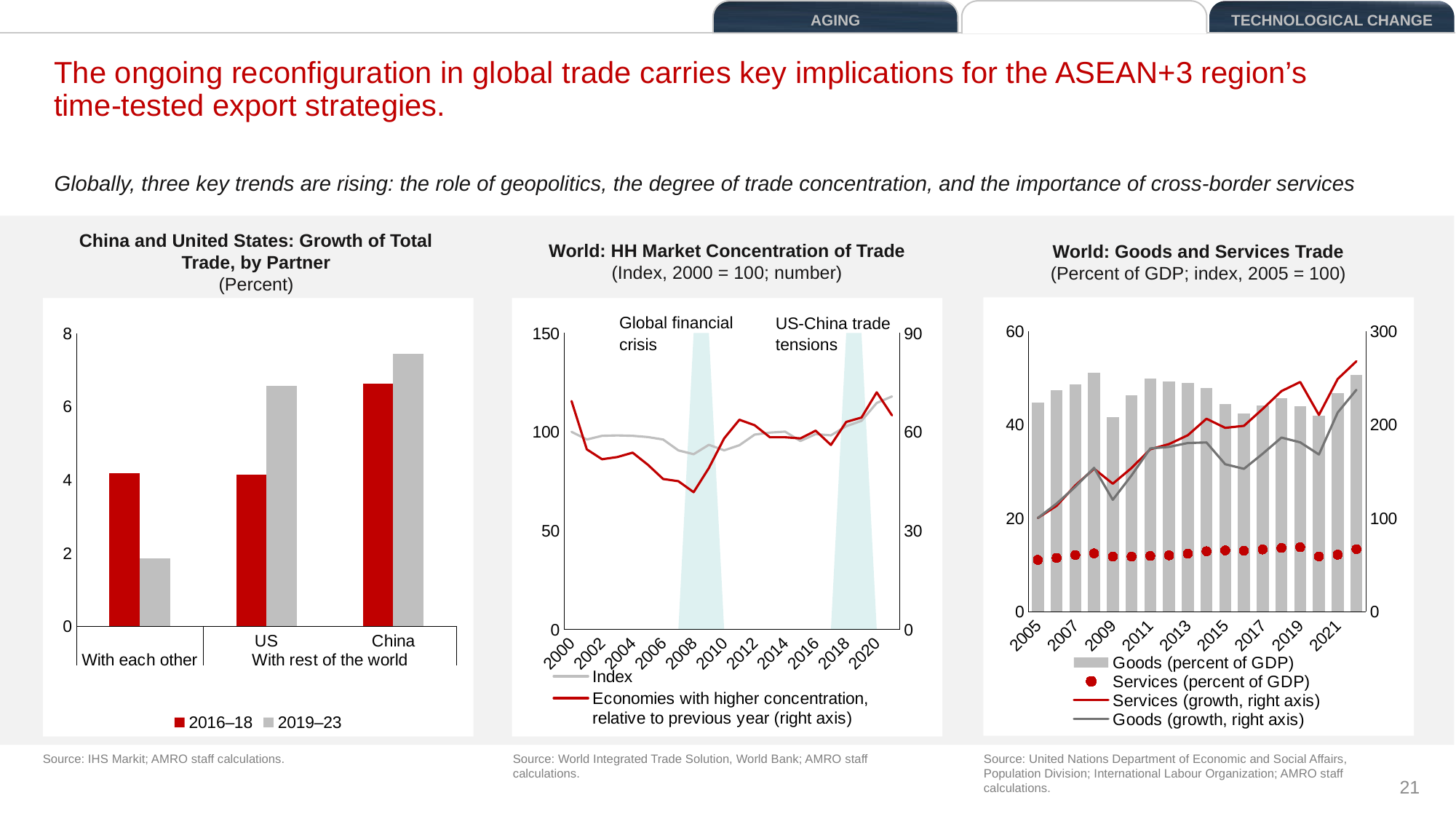
In 'China and United States: Growth of Total Trade, by Partner', is the 2019–23 value for 'With each other' greater or less than 4? less What kind of chart is 'World: HH Market Concentration of Trade'? line chart In 'China and United States: Growth of Total Trade, by Partner', for 'With each other', which series is larger: 2016–18 or 2019–23? 2016–18 How many series does the legend of 'World: Goods and Services Trade' list? 4 In 'China and United States: Growth of Total Trade, by Partner', which category has the lowest 2019–23 value? With each other In 'China and United States: Growth of Total Trade, by Partner', which category has the highest 2019–23 value? China How many series does the legend of 'China and United States: Growth of Total Trade, by Partner' list? 2 What two events are labelled by the shaded areas in 'World: HH Market Concentration of Trade'? Global financial crisis; US-China trade tensions What kind of chart is 'China and United States: Growth of Total Trade, by Partner'? bar chart How many categories are shown on the x axis of 'China and United States: Growth of Total Trade, by Partner'? 3 In 'World: HH Market Concentration of Trade', is the Index value in 2008 greater or less than 100? less In 'China and United States: Growth of Total Trade, by Partner', is the 2019–23 value for US (with rest of the world) greater or less than 6? greater